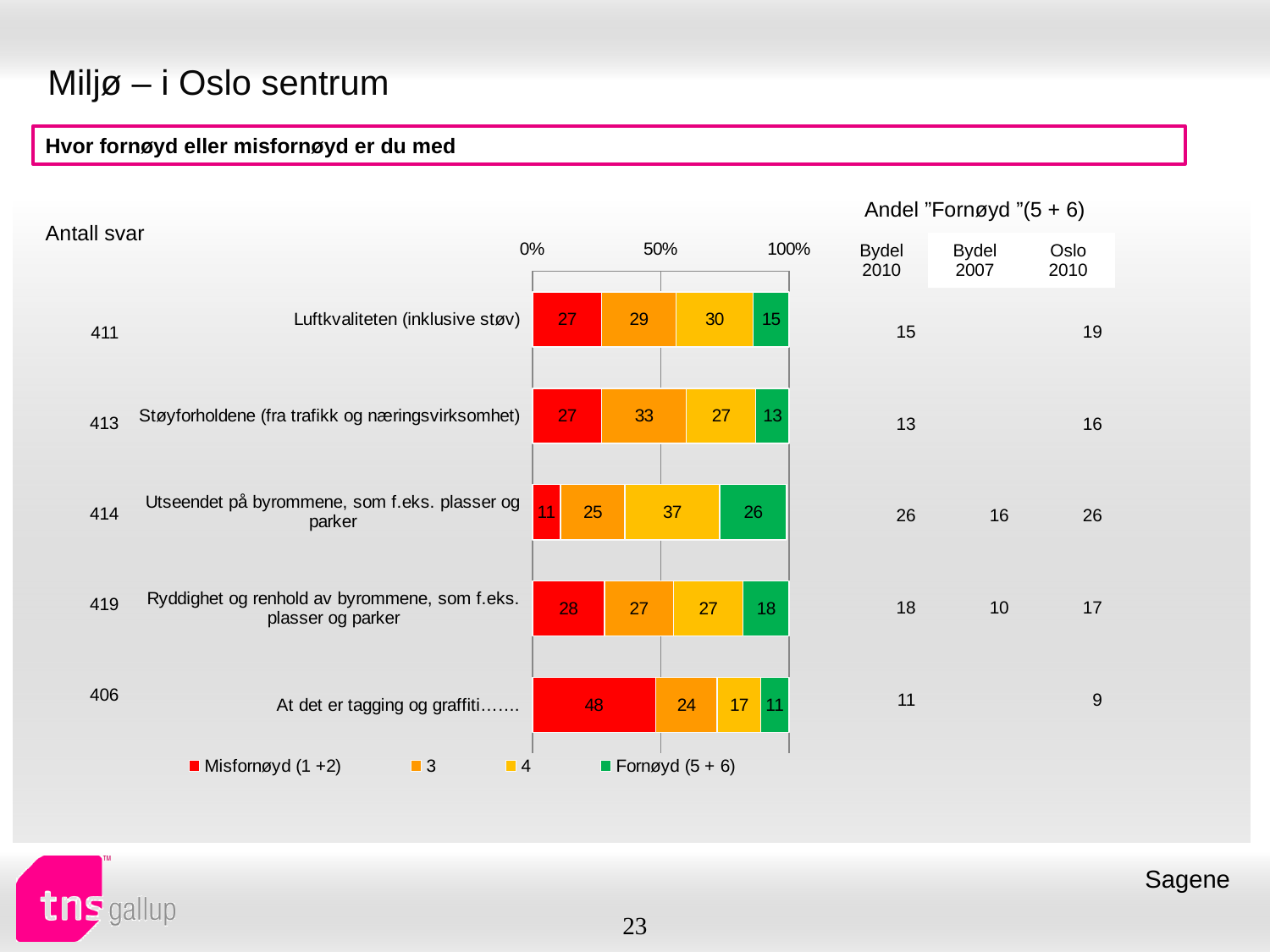
What is the value of the Misfornøyd (1 +2) series for "At det er tagging og graffiti…"? 48 Which is larger: the Misfornøyd (1 +2) value for "Ryddighet og renhold av byrommene" or for "Utseendet på byrommene"? Ryddighet og renhold av byrommene How many categories are shown in the chart? 5 How many series does the legend list? 4 What is the value of the Fornøyd (5 + 6) series for "Utseendet på byrommene, som f.eks. plasser og parker"? 26 Which category has the lowest Fornøyd (5 + 6) value? At det er tagging og graffiti… Which category has the highest Misfornøyd (1 +2) value? At det er tagging og graffiti… What is the total of the stacked bar for "Støyforholdene (fra trafikk og næringsvirksomhet)"? 100 What is the value of series 3 for "Støyforholdene (fra trafikk og næringsvirksomhet)"? 33 What kind of chart is shown on the slide? Stacked bar chart What colour represents the Fornøyd (5 + 6) series in the chart? Green What is the difference between the Fornøyd (5 + 6) values for "Utseendet på byrommene, som f.eks. plasser og parker" and "Luftkvaliteten (inklusive støv)"? 11